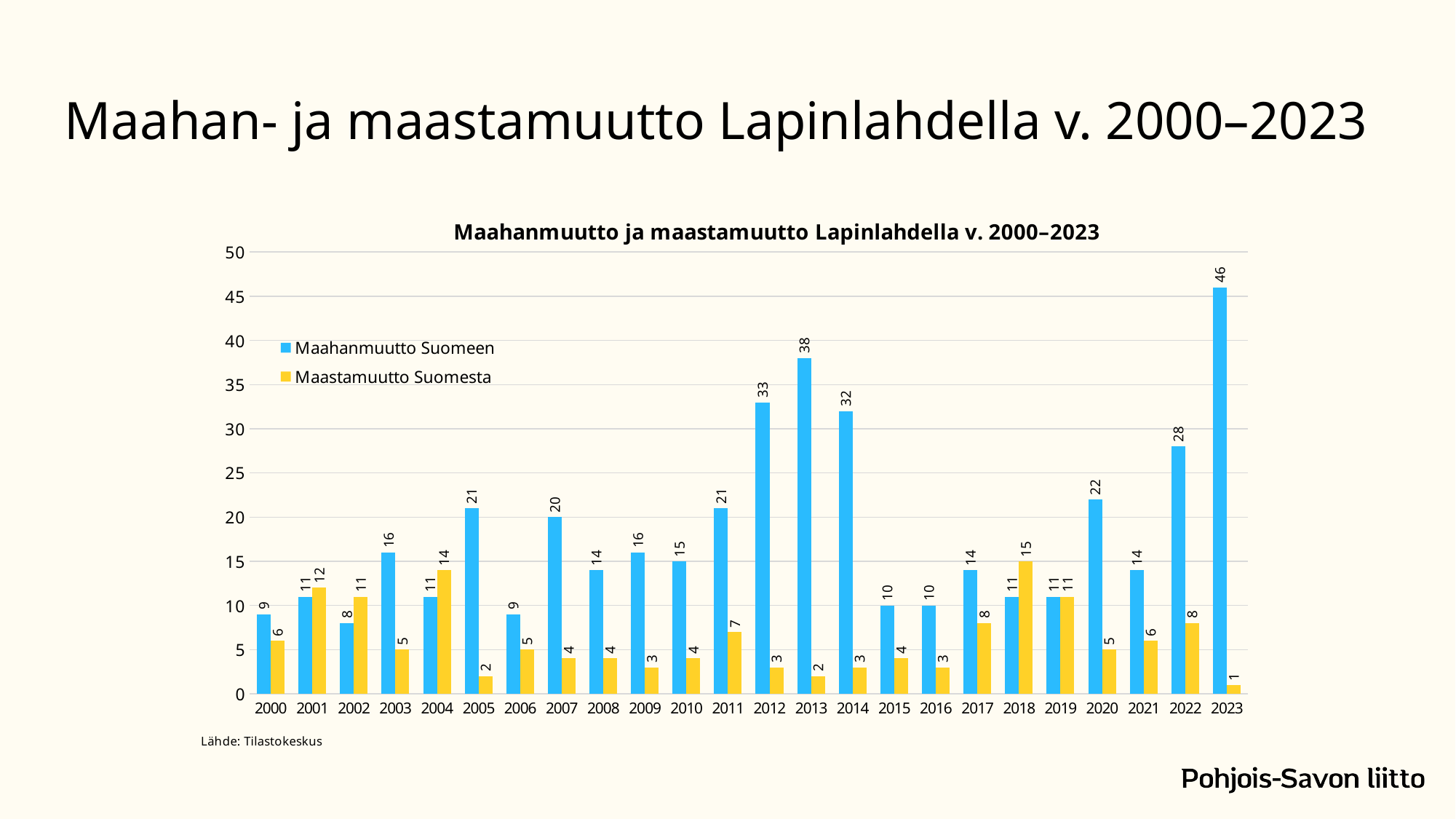
What is the value of Maahanmuutto Suomeen in 2013? 38 What is the title of the chart? Maahanmuutto ja maastamuutto Lapinlahdella v. 2000–2023 Is the value for Maahanmuutto Suomeen in 2012 greater or less than 30? greater How many years are shown on the x axis? 24 How many series does the legend list? 2 In which year is Maastamuutto Suomesta lowest? 2023 What is the value of Maahanmuutto Suomeen in 2023? 46 In which year is Maahanmuutto Suomeen highest? 2023 What kind of chart is shown on the slide? Bar chart What is the difference between Maahanmuutto Suomeen and Maastamuutto Suomesta in 2022? 20 Which is larger in 2004, Maahanmuutto Suomeen or Maastamuutto Suomesta? Maastamuutto Suomesta What is the value of Maastamuutto Suomesta in 2018? 15